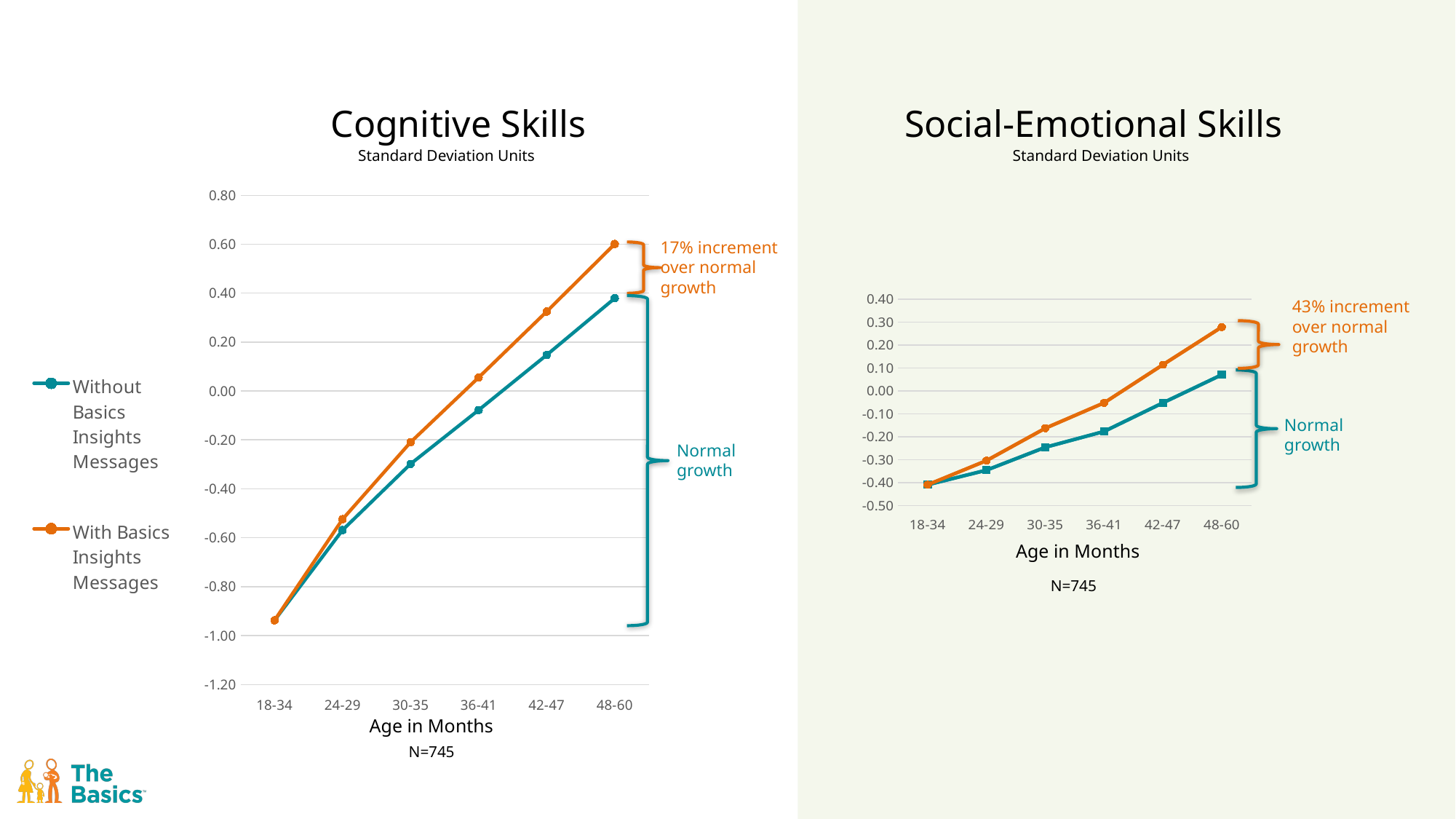
In the Social-Emotional Skills chart, is the value for With Basics Insights Messages at 48-60 months greater or less than 0.20? greater In the Cognitive Skills chart, do the values rise or fall as age in months increases? rise How many age groups are plotted on the x axis of the Social-Emotional Skills chart? 6 How many series does the legend list for the charts? 2 In the Cognitive Skills chart, is the value for Without Basics Insights Messages at 48-60 months greater or less than 0.40? less What sample size (N) is shown beneath the Cognitive Skills chart? N=745 In the Cognitive Skills chart, is the value for With Basics Insights Messages at 18-34 months greater or less than -0.80? less What kind of chart is the Cognitive Skills chart? line chart In the Cognitive Skills chart, which age group has the lowest values for both series? 18-34 What increment over normal growth is annotated on the Social-Emotional Skills chart? 43% increment over normal growth In the Social-Emotional Skills chart, which series is higher at 48-60 months: With Basics Insights Messages or Without Basics Insights Messages? With Basics Insights Messages